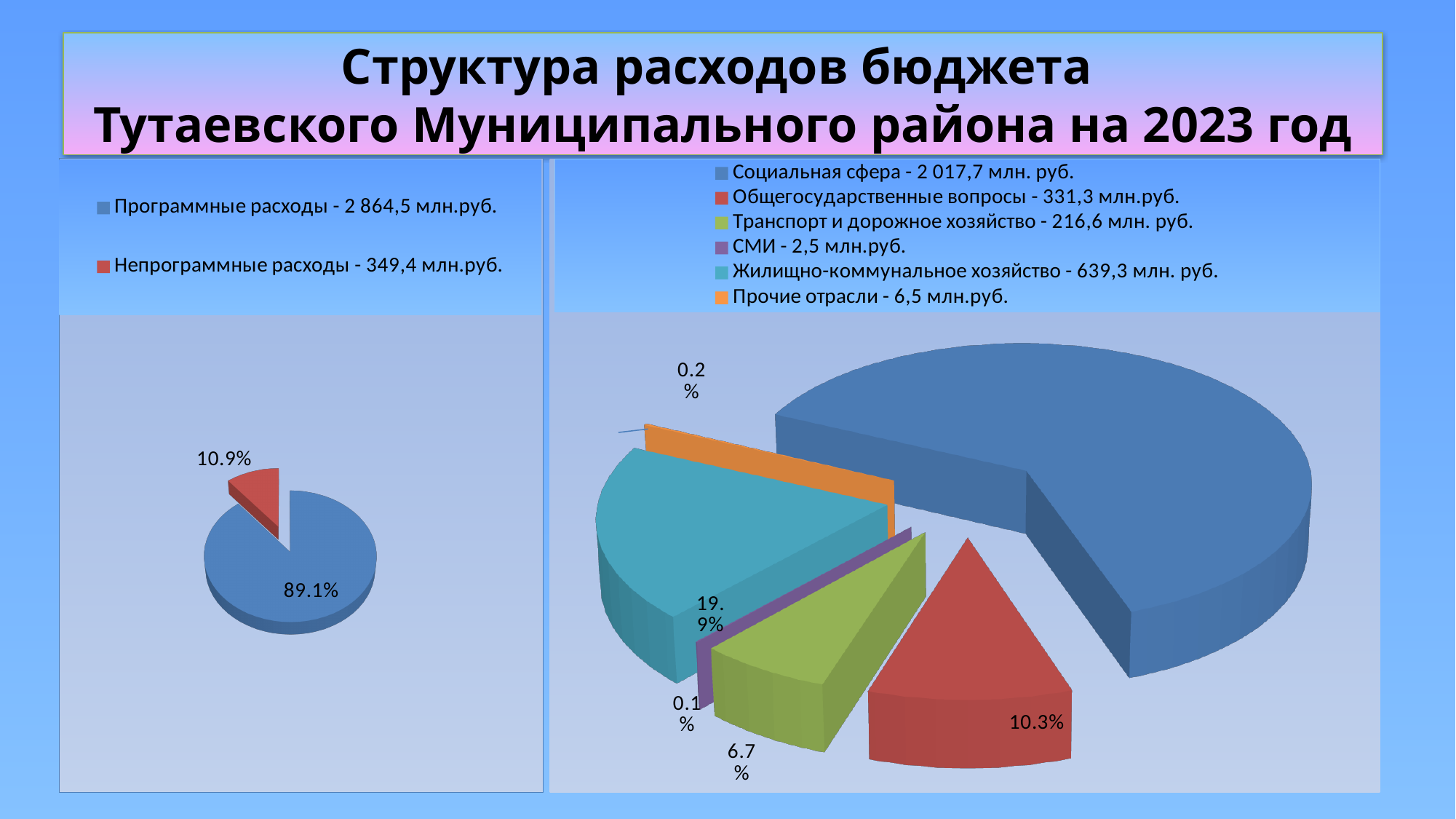
In the left pie chart, what share is shown for Непрограммные расходы? 10.9% In the right pie chart, what share is shown for Транспорт и дорожное хозяйство? 6.7% In the right pie chart, what share is shown for Общегосударственные вопросы? 10.3% In the right pie chart, how many categories does the legend list? 6 In the right pie chart, which category has the largest slice? Социальная сфера In the left pie chart, what value does the legend give for Непрограммные расходы? 349,4 млн.руб. In the right pie chart, what value does the legend give for Социальная сфера? 2 017,7 млн. руб. In the right pie chart, which category has the smallest share? СМИ In the left pie chart, how many categories does the legend list? 2 What kind of chart is shown on the left side of the slide? pie chart